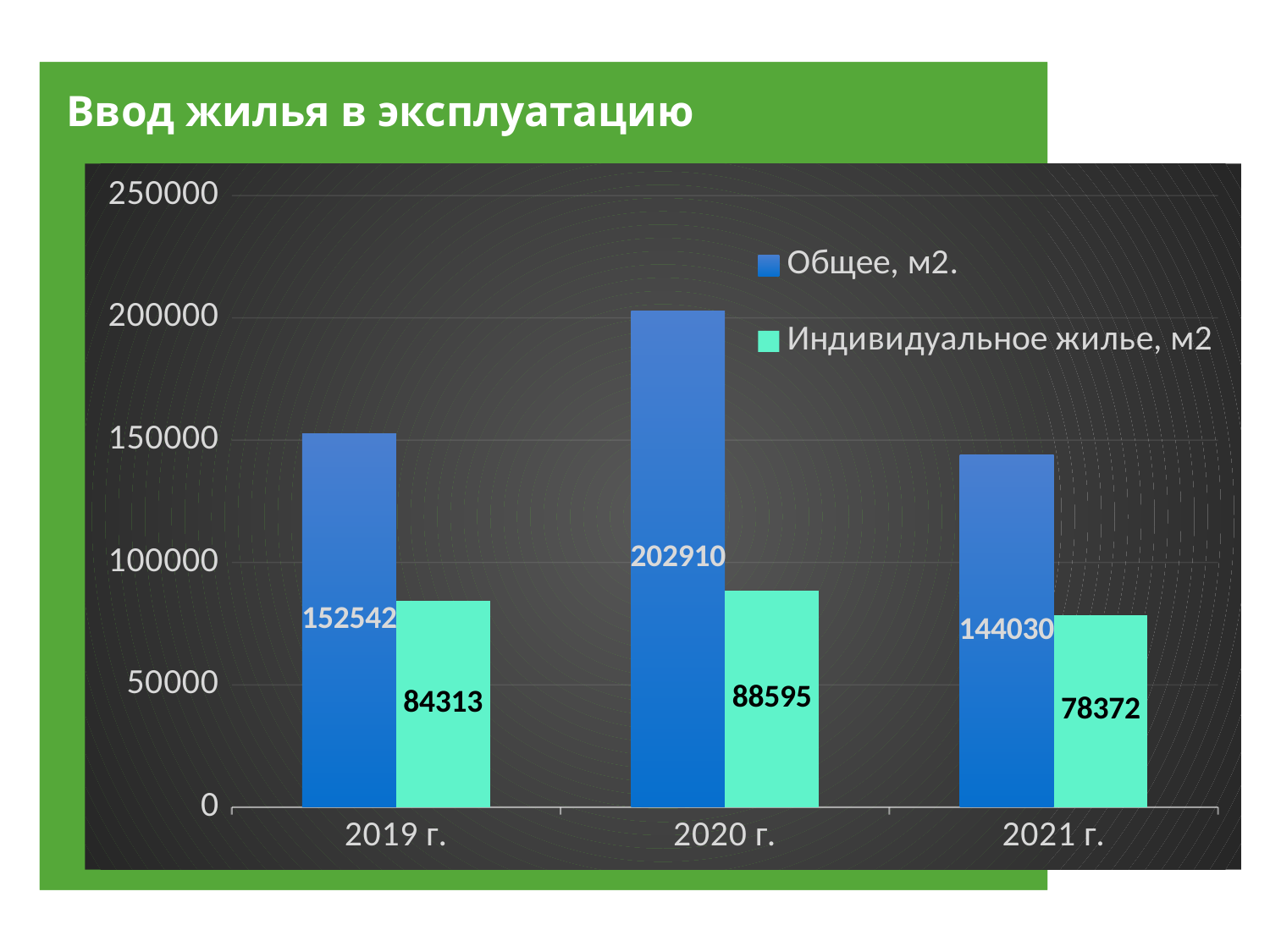
Which year has the lowest value for "Индивидуальное жилье, м2"? 2021 г. What is the value of "Индивидуальное жилье, м2" for 2021 г.? 78372 How many series does the legend list? 2 Which year has the highest value for "Общее, м2."? 2020 г. What is the difference between "Общее, м2." and "Индивидуальное жилье, м2" in 2020 г.? 114315 How many years are shown on the x axis? 3 What is the value of "Общее, м2." for 2019 г.? 152542 What is the value of "Общее, м2." for 2020 г.? 202910 Is the value of "Общее, м2." for 2021 г. greater or less than 150000? less Which is larger: "Индивидуальное жилье, м2" in 2019 г. or in 2020 г.? 2020 г. What kind of chart is shown on the slide? bar chart What is the title of the chart? Ввод жилья в эксплуатацию